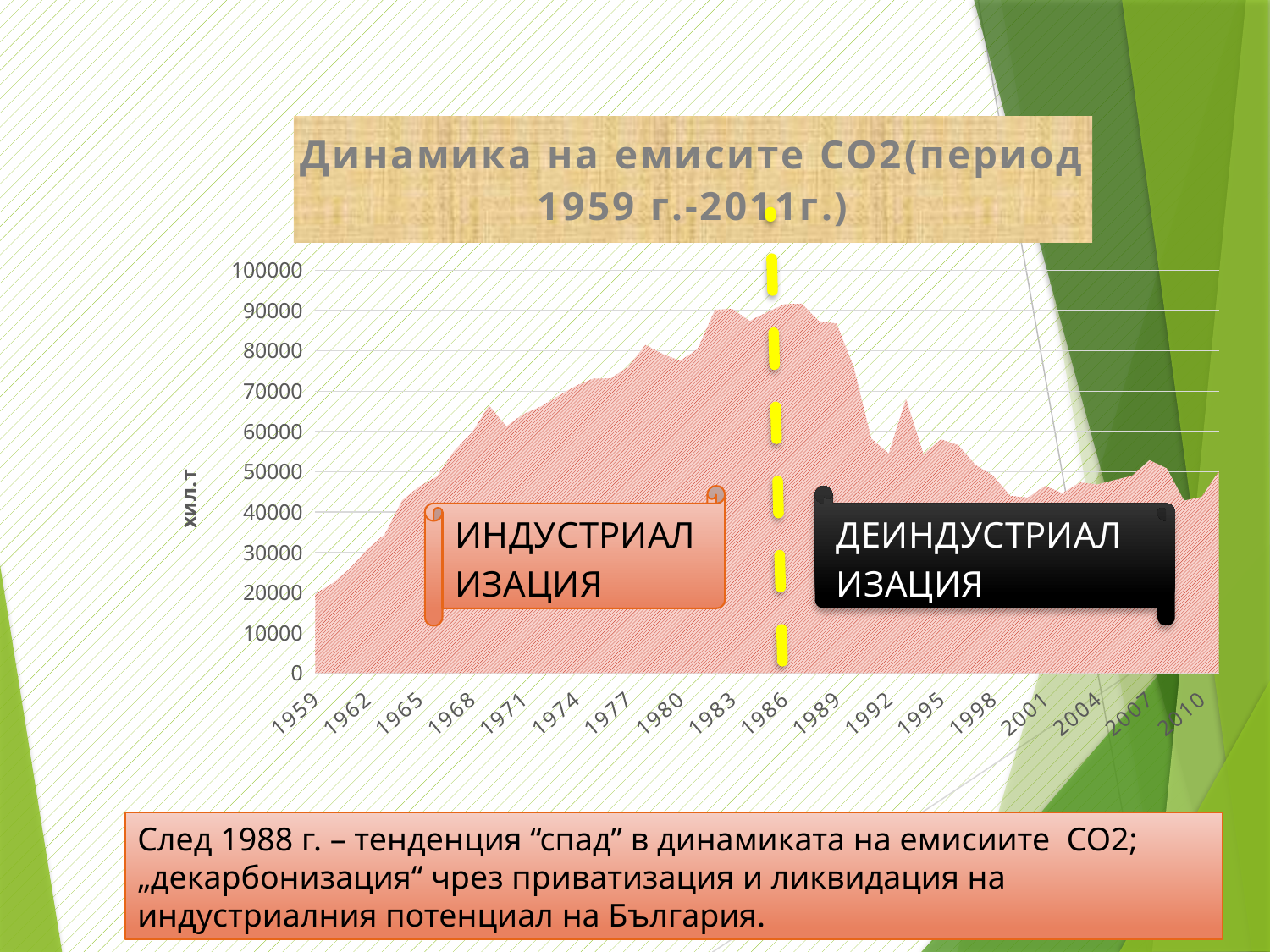
What kind of chart is shown on the slide? Area chart Is the value for 1986 greater or less than 80000? greater Is the value for 1959 greater or less than 30000? less Is the value for 1995 greater or less than 40000? greater How many year labels are shown along the x axis? 18 Do the values generally rise or fall between 1989 and 2010? fall What is the label on the vertical axis of the chart? хил.т Do the values generally rise or fall between 1959 and 1986? rise What is the title of the chart? Динамика на емисите CO2(период 1959 г.-2011г.) Which year has the larger value, 1986 or 2010? 1986